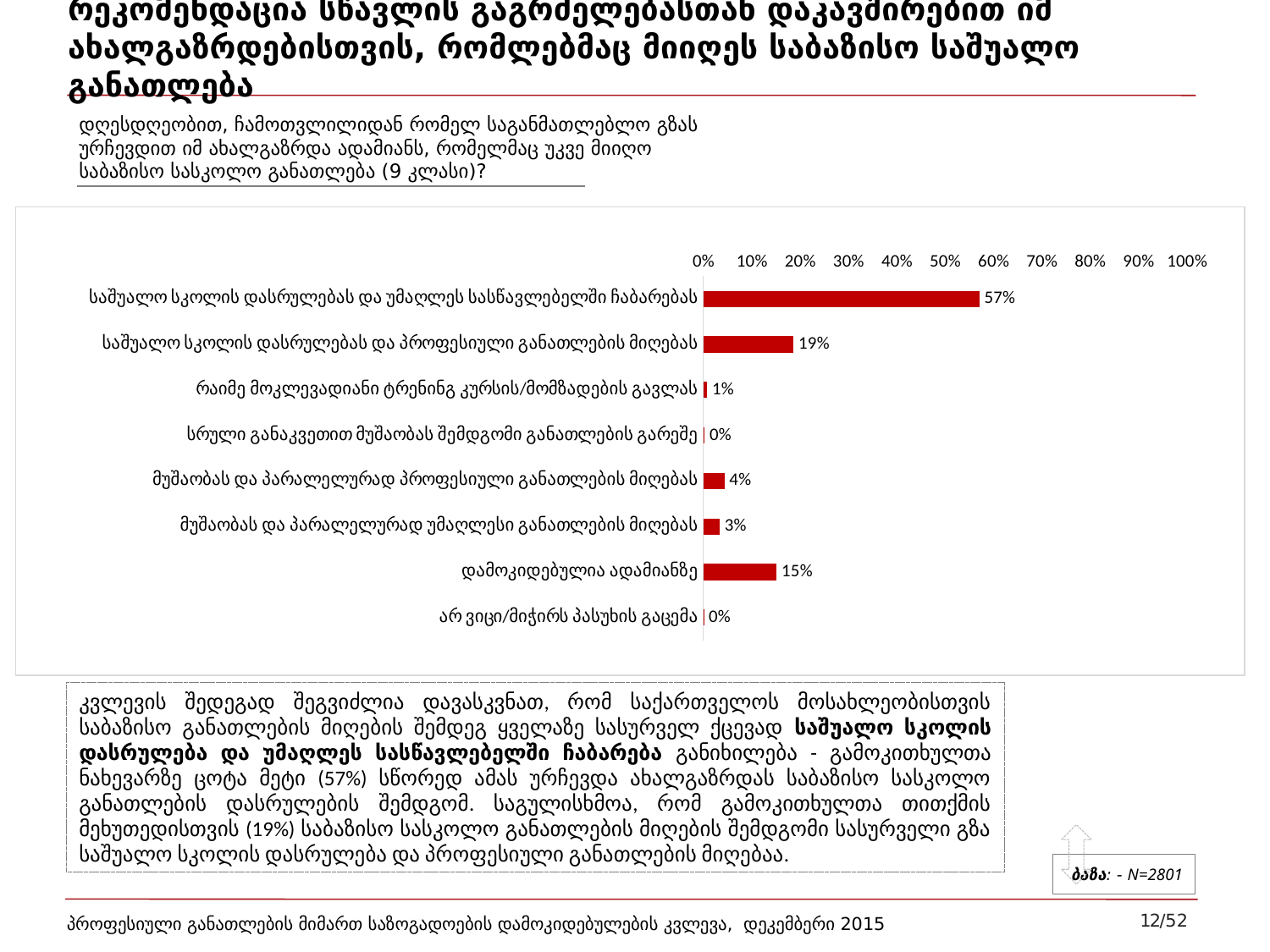
Which is larger: the value for "დამოკიდებულია ადამიანზე" or the value for "საშუალო სკოლის დასრულებას და პროფესიული განათლების მიღებას"? საშუალო სკოლის დასრულებას და პროფესიული განათლების მიღებას Is the value for "საშუალო სკოლის დასრულებას და უმაღლეს სასწავლებელში ჩაბარებას" greater or less than 50%? greater Which category has the highest value in the chart? საშუალო სკოლის დასრულებას და უმაღლეს სასწავლებელში ჩაბარებას What is the difference between the values for "საშუალო სკოლის დასრულებას და უმაღლეს სასწავლებელში ჩაბარებას" and "საშუალო სკოლის დასრულებას და პროფესიული განათლების მიღებას"? 38 percentage points How many categories are plotted in the chart? 8 What is the value for "დამოკიდებულია ადამიანზე"? 15% What is the value for "საშუალო სკოლის დასრულებას და უმაღლეს სასწავლებელში ჩაბარებას"? 57% What is the maximum value shown on the chart's percentage axis? 100% What kind of chart is shown on the slide? bar chart What is the value for "რაიმე მოკლევადიანი ტრენინგ კურსის/მომზადების გავლას"? 1% What is the value for "მუშაობას და პარალელურად პროფესიული განათლების მიღებას"? 4% What is the value for "საშუალო სკოლის დასრულებას და პროფესიული განათლების მიღებას"? 19%